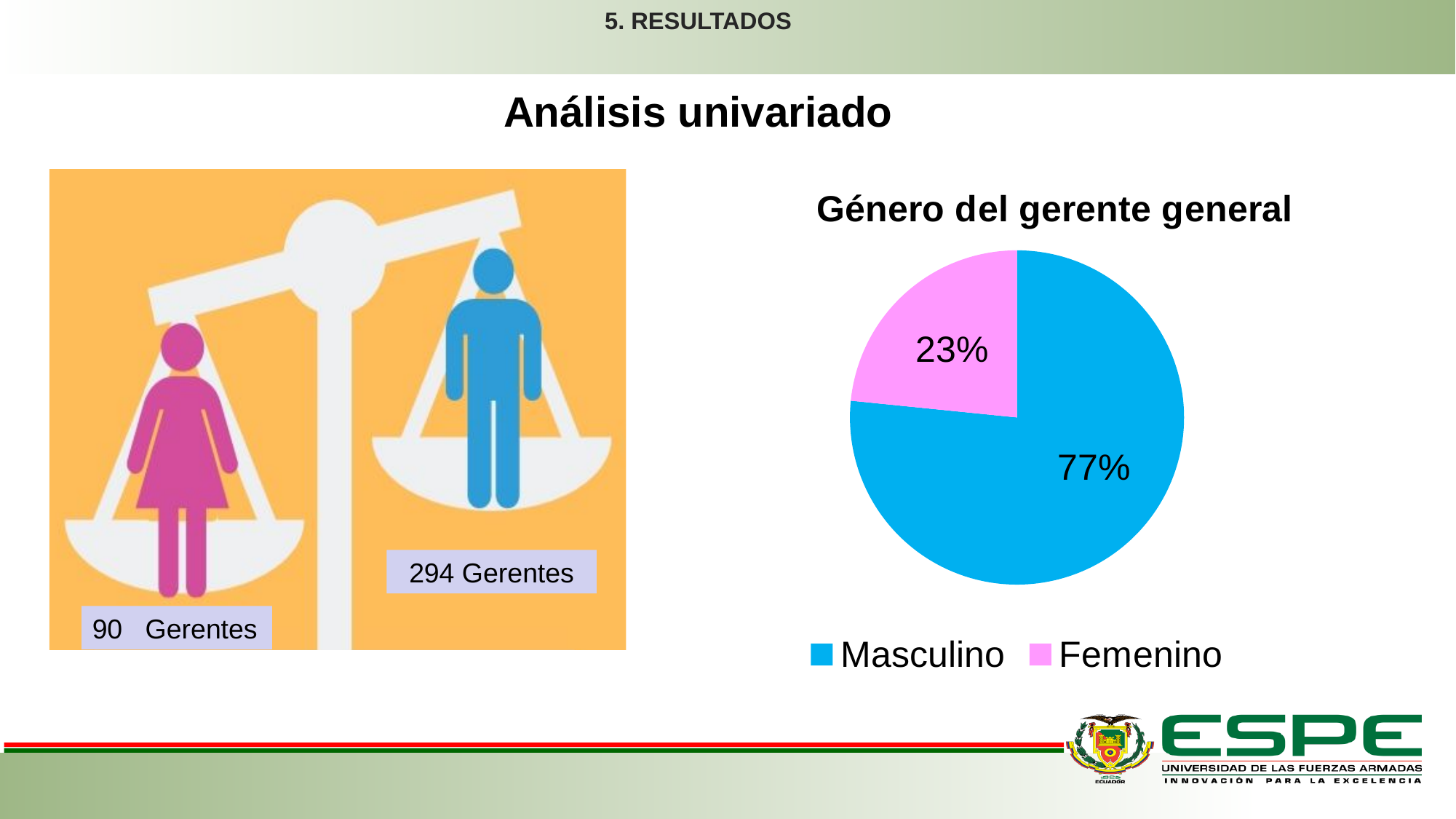
What share of the pie chart 'Género del gerente general' is Masculino? 77% How many categories does the pie chart 'Género del gerente general' show? 2 What kind of chart is 'Género del gerente general'? Pie chart Which category has the smallest slice in the pie chart 'Género del gerente general'? Femenino Which category has the largest slice in the pie chart 'Género del gerente general'? Masculino In the pie chart 'Género del gerente general', what colour is the Femenino slice? Pink How many entries does the legend of the pie chart 'Género del gerente general' list? 2 In the pie chart 'Género del gerente general', which is larger, Masculino or Femenino? Masculino What is the title of the pie chart on the right of the slide? Género del gerente general In the pie chart 'Género del gerente general', what is the difference in percentage points between Masculino and Femenino? 54 What share of the pie chart 'Género del gerente general' is Femenino? 23%